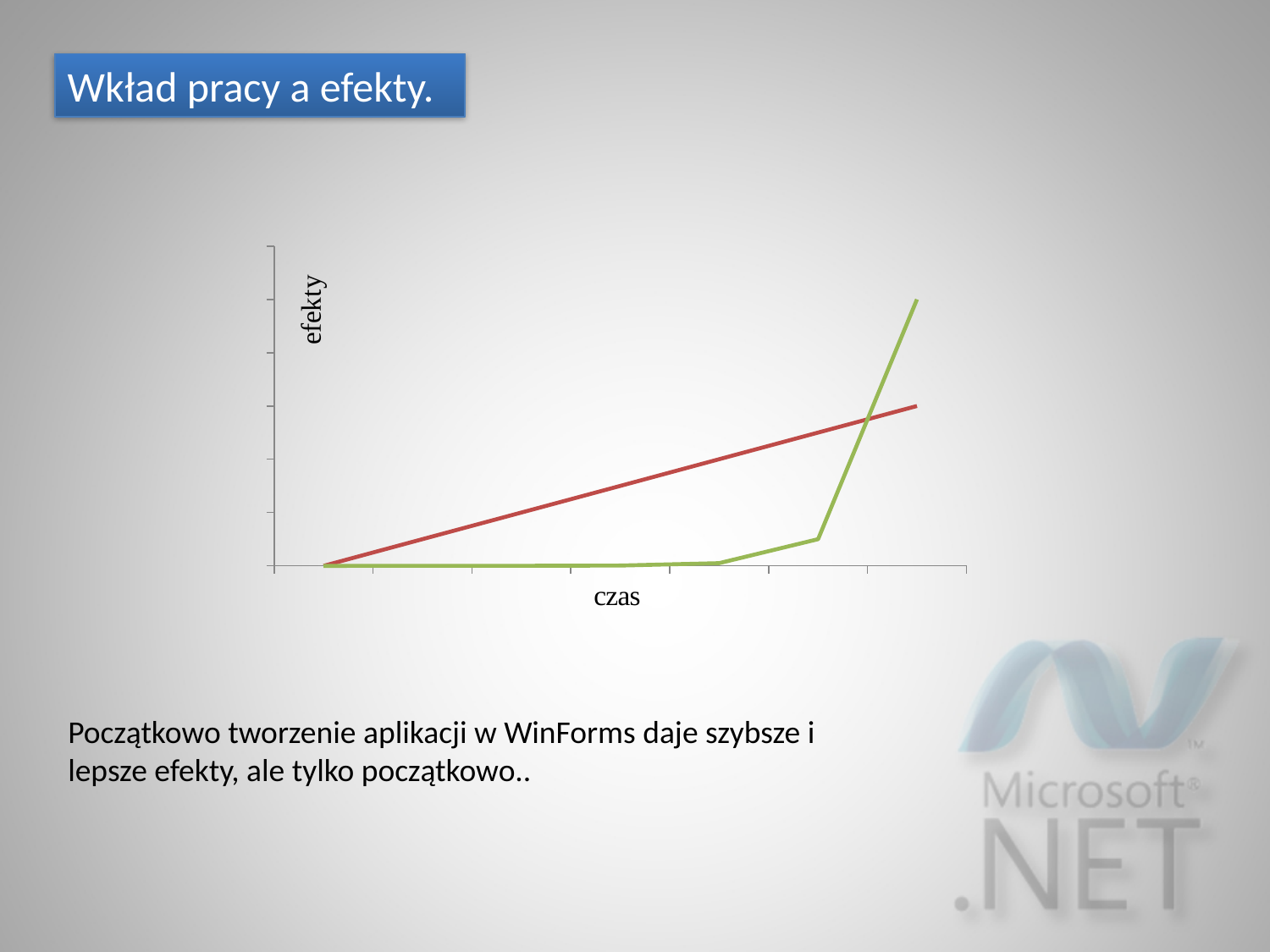
Which line increases at a steady, constant rate across the whole chart? red line How many lines are plotted on the chart? 2 Which line stays flat near zero for most of the x axis before rising sharply at the end? green line In the middle of the x axis, which line is higher, the red line or the green line? red line At the right end of the chart, which line reaches the higher value, the red line or the green line? green line What kind of chart is shown on the slide? line chart What is the label of the horizontal axis of the chart? czas Does the green line rise or fall overall from left to right? rise What is the label of the vertical axis of the chart? efekty Does the red line rise or fall as it moves along the x axis? rise